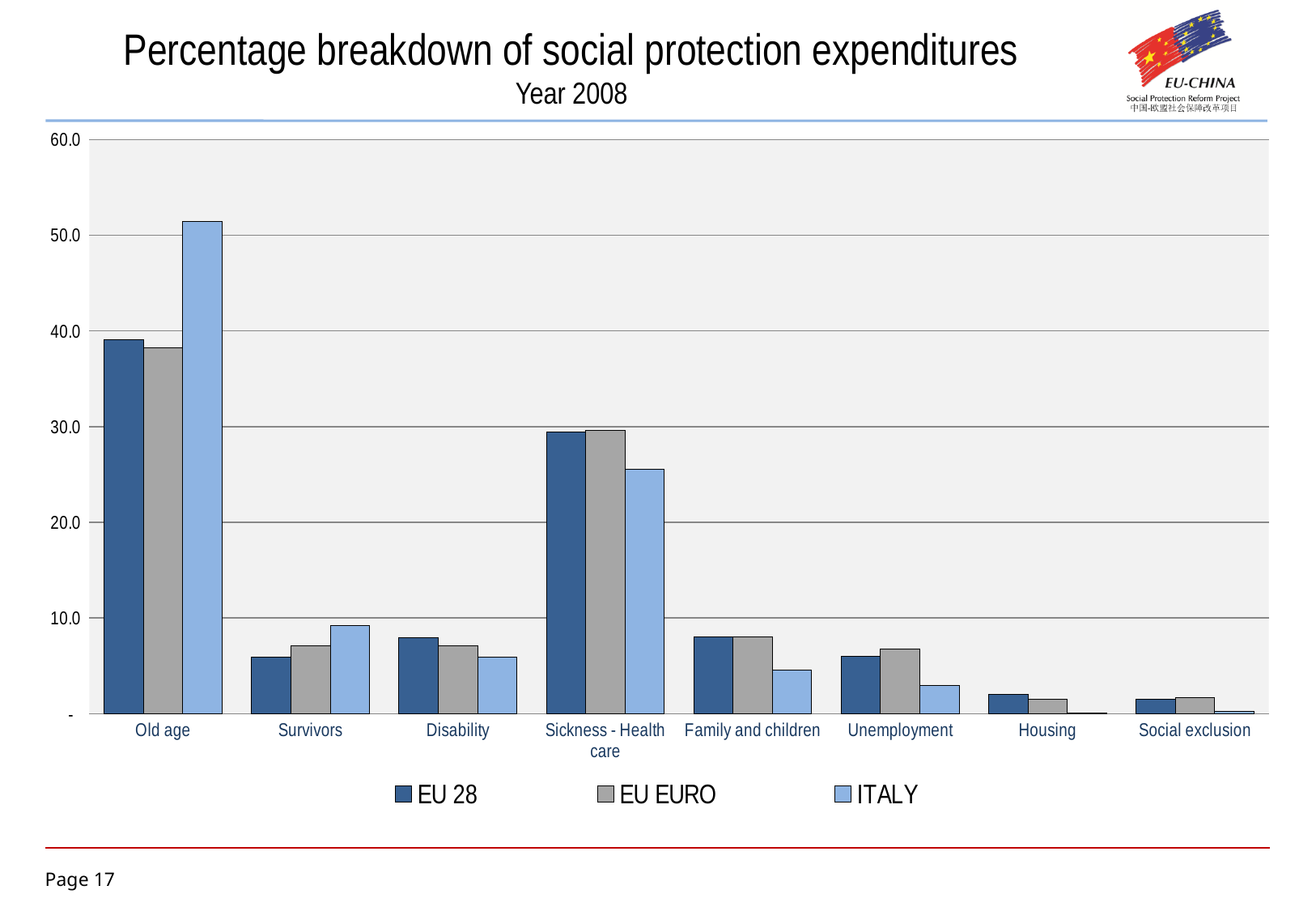
Is the ITALY value for Sickness - Health care greater or less than 30.0? less What are the three series named in the legend? EU 28, EU EURO, ITALY How many series does the legend list? 3 Which category has the highest value for EU 28? Old age Is the EU 28 value for Old age greater or less than 30.0? greater How many expenditure categories are shown on the x axis? 8 For Family and children, which is larger: the EU 28 value or the ITALY value? EU 28 Which category has the highest value for ITALY? Old age Is the ITALY value for Survivors greater or less than 10.0? less For Old age, which is larger: the EU 28 value or the ITALY value? ITALY What kind of chart is shown on the slide? Bar chart